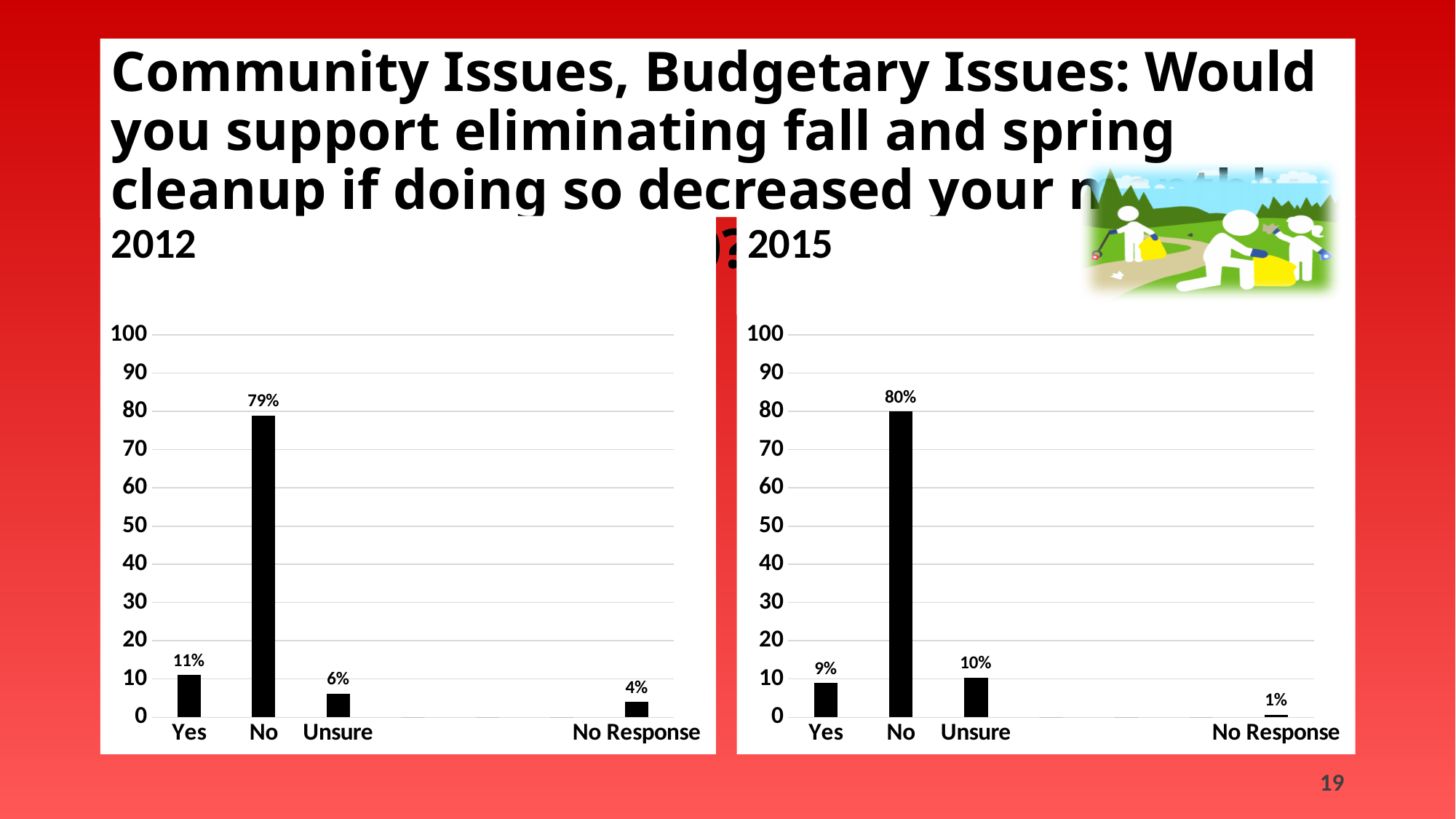
In the 2012 chart, what is the value for No Response? 4% In the 2012 chart, which is larger, the value for Yes or the value for Unsure? Yes What kind of chart is the 2015 chart? bar chart In the 2015 chart, what is the value for Unsure? 10% In the 2012 chart, which category has the lowest value? No Response In the 2015 chart, what is the value for Yes? 9% In the 2012 chart, what is the difference between the values for No and Yes? 68% In the 2015 chart, which category has the highest value? No In the 2015 chart, is the value for No greater or less than 70? greater In the 2012 chart, what is the value for No? 79% In the 2015 chart, what is the difference between the values for Unsure and No Response? 9% How many categories are shown on the x axis of the 2012 chart? 4